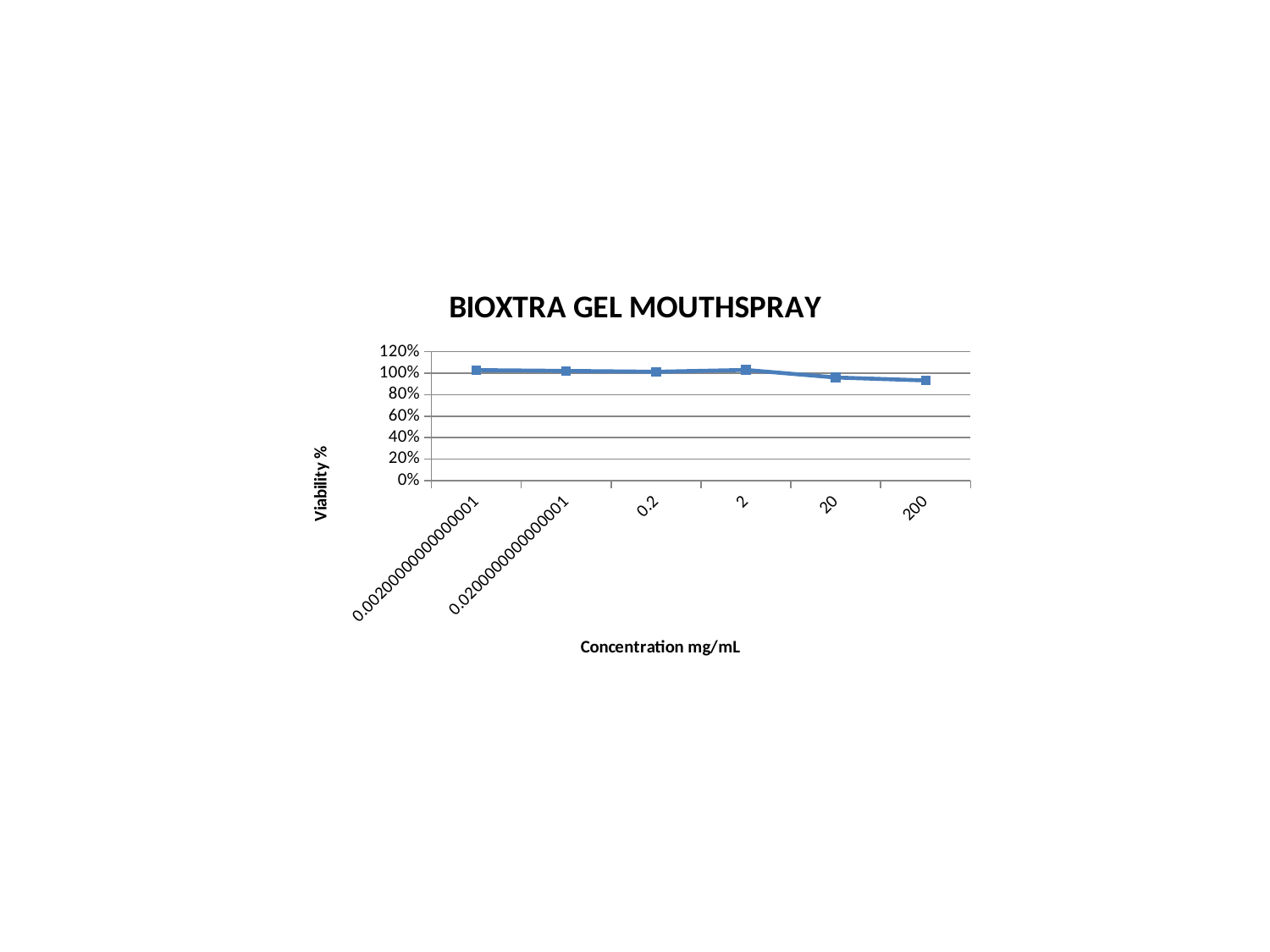
What is the label of the x axis? Concentration mg/mL How many concentration points are plotted on the chart? 6 Is the viability value at a concentration of 20 greater or less than 60%? greater Which concentration has the lowest viability? 200 Which has the higher viability, a concentration of 0.2 or a concentration of 200? 0.2 Is the viability value at a concentration of 200 greater or less than 100%? less What kind of chart is shown on the slide? line chart Does viability rise or fall overall as concentration increases along the x axis? fall What is the title of the chart? BIOXTRA GEL MOUTHSPRAY Is the viability value at a concentration of 2 greater or less than 80%? greater